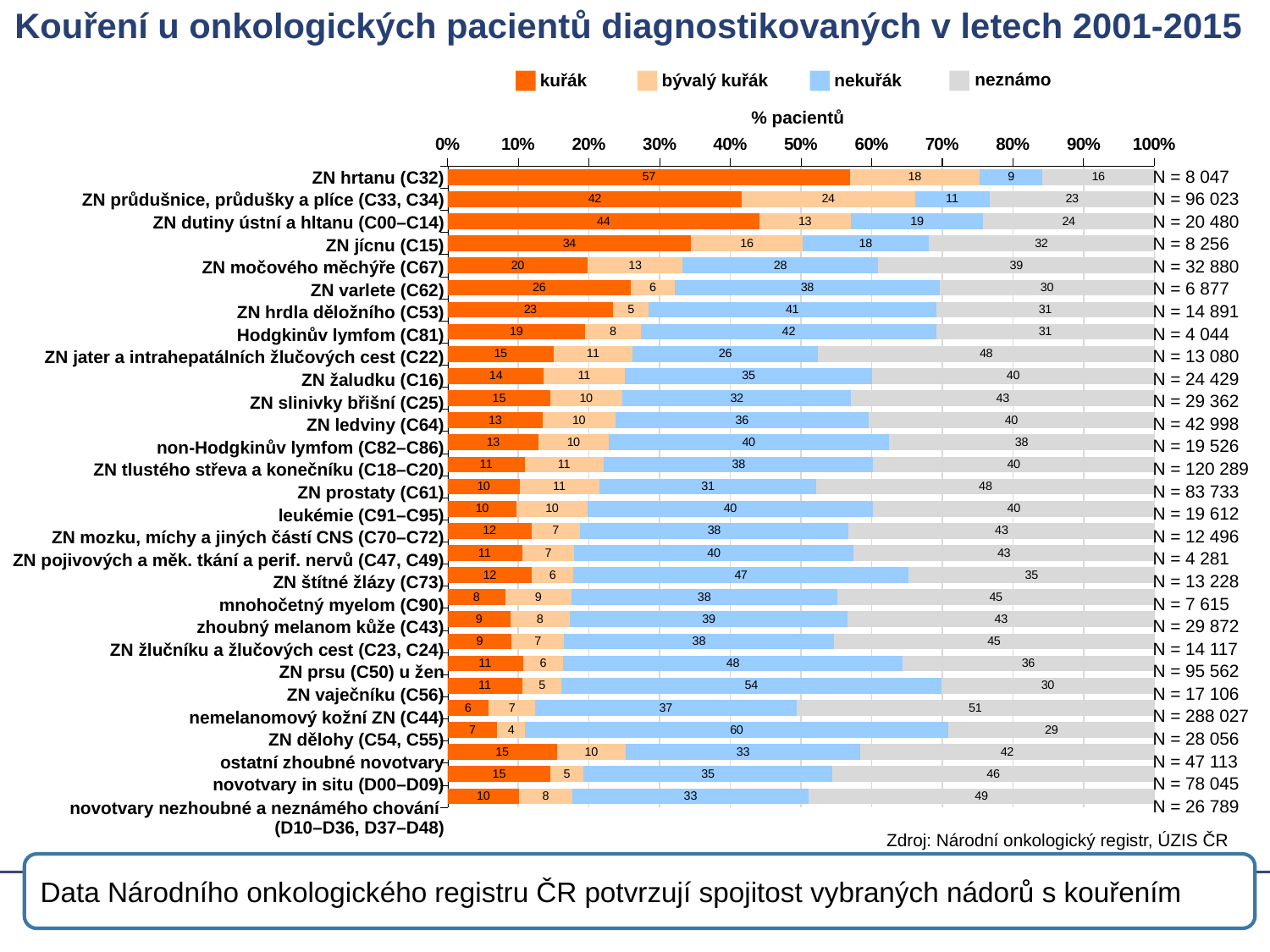
Which category has the highest kuřák value? ZN hrtanu (C32) How many series does the legend list? 4 Which category has the lowest kuřák value? nemelanomový kožní ZN (C44) What is the bývalý kuřák value for ZN průdušnice, průdušky a plíce (C33, C34)? 24 What kind of chart is shown on the slide? bar chart What is the difference between the kuřák values for ZN hrtanu (C32) and ZN průdušnice, průdušky a plíce (C33, C34)? 15 What is the N value shown for ZN průdušnice, průdušky a plíce (C33, C34)? 96 023 What is the kuřák value for ZN hrtanu (C32)? 57 Which has the larger kuřák value, ZN jícnu (C15) or ZN močového měchýře (C67)? ZN jícnu (C15) How many categories (diagnoses) are shown in the chart? 29 What is the title of the horizontal axis? % pacientů What is the nekuřák value for ZN hrdla děložního (C53)? 41